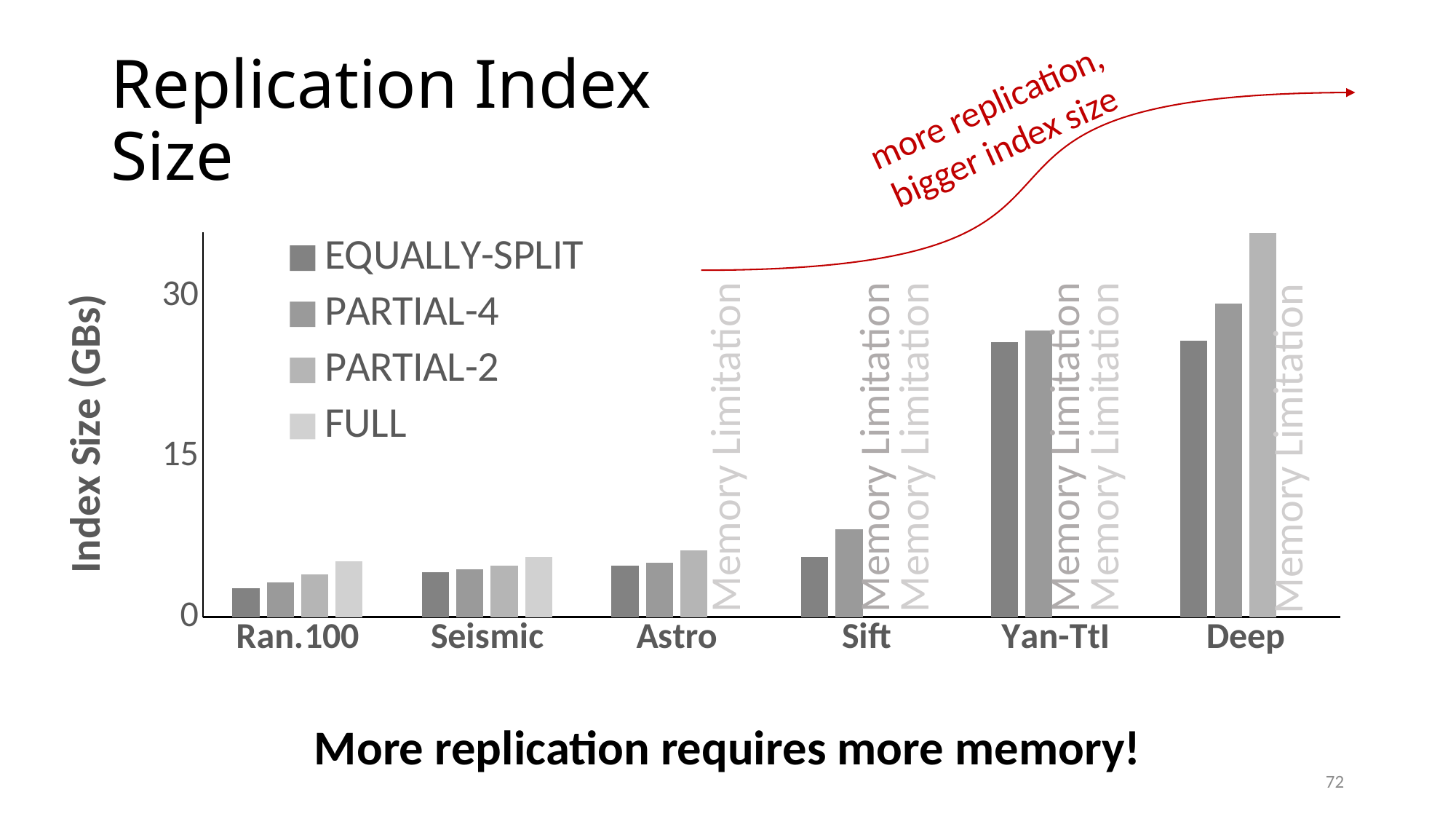
Which category has the shortest bars in the chart? Ran.100 Which category has the tallest bar in the chart? Deep How many categories are shown on the x axis? 6 Is the EQUALLY-SPLIT value for Yan-Ttl greater or less than 15? greater How many series does the legend list? 4 What is the title of the y axis? Index Size (GBs) Which series is shown with the lightest bars according to the legend? FULL Is the PARTIAL-4 value for Sift greater or less than 15? less Do the EQUALLY-SPLIT values generally rise or fall from Ran.100 to Deep? rise What kind of chart is shown on the slide? bar chart